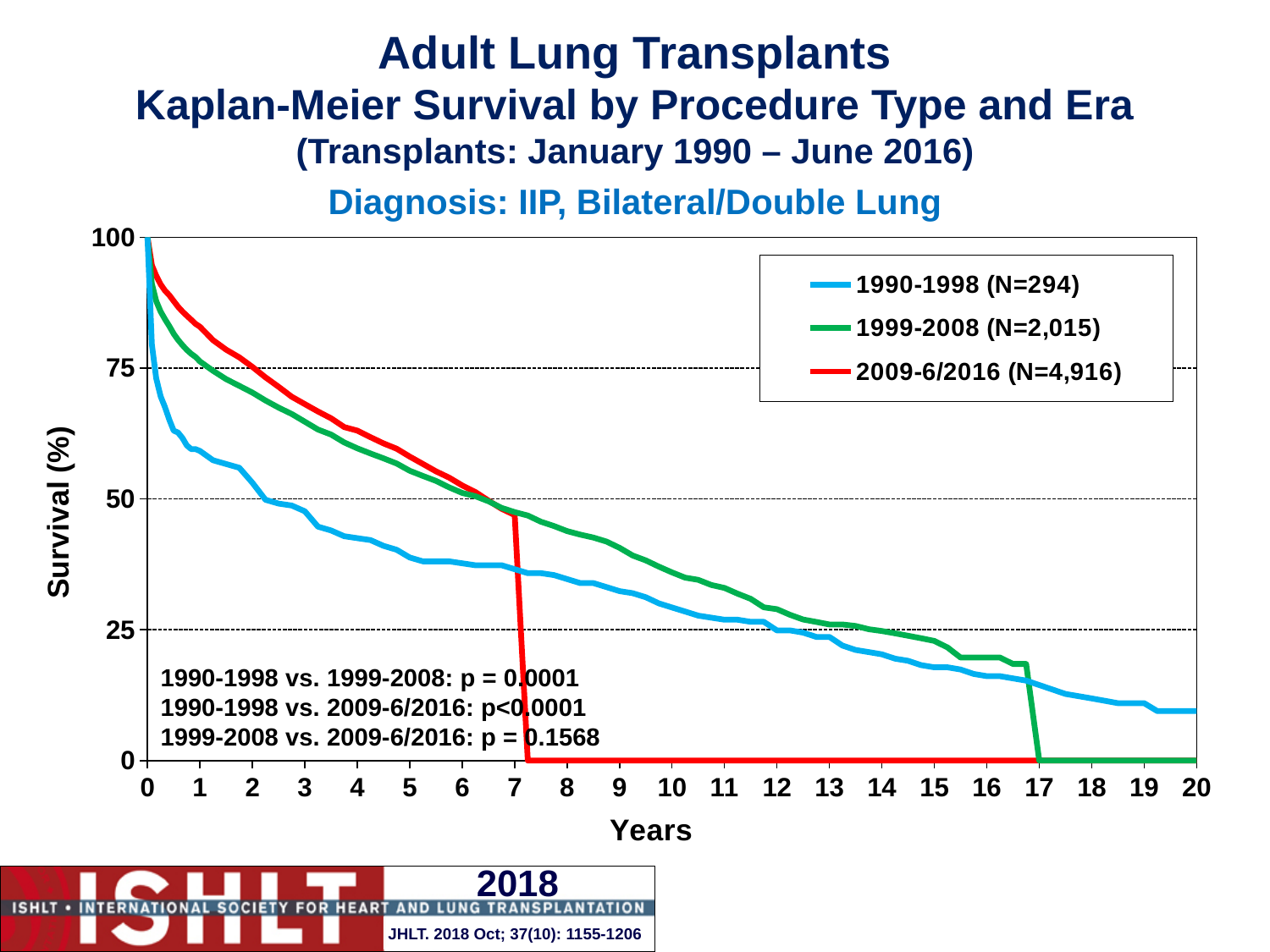
Is the survival for the 1990-1998 era at year 5 greater or less than 50? less Is the survival for the 1999-2008 era at year 10 greater or less than 25? greater What survival value do all three curves start at in year 0? 100 At year 1, which era has higher survival, 1990-1998 or 2009-6/2016? 2009-6/2016 At year 10, which era has higher survival, 1990-1998 or 1999-2008? 1999-2008 What kind of chart is shown on the slide? line chart What is the N for the 1999-2008 era shown in the legend? 2,015 Do the survival curves rise or fall as years increase along the x axis? fall What is the maximum value shown on the Years axis? 20 How many series does the legend list? 3 Is the survival for the 2009-6/2016 era at year 1 greater or less than 75? greater What is the p-value shown for 1999-2008 vs. 2009-6/2016? p = 0.1568